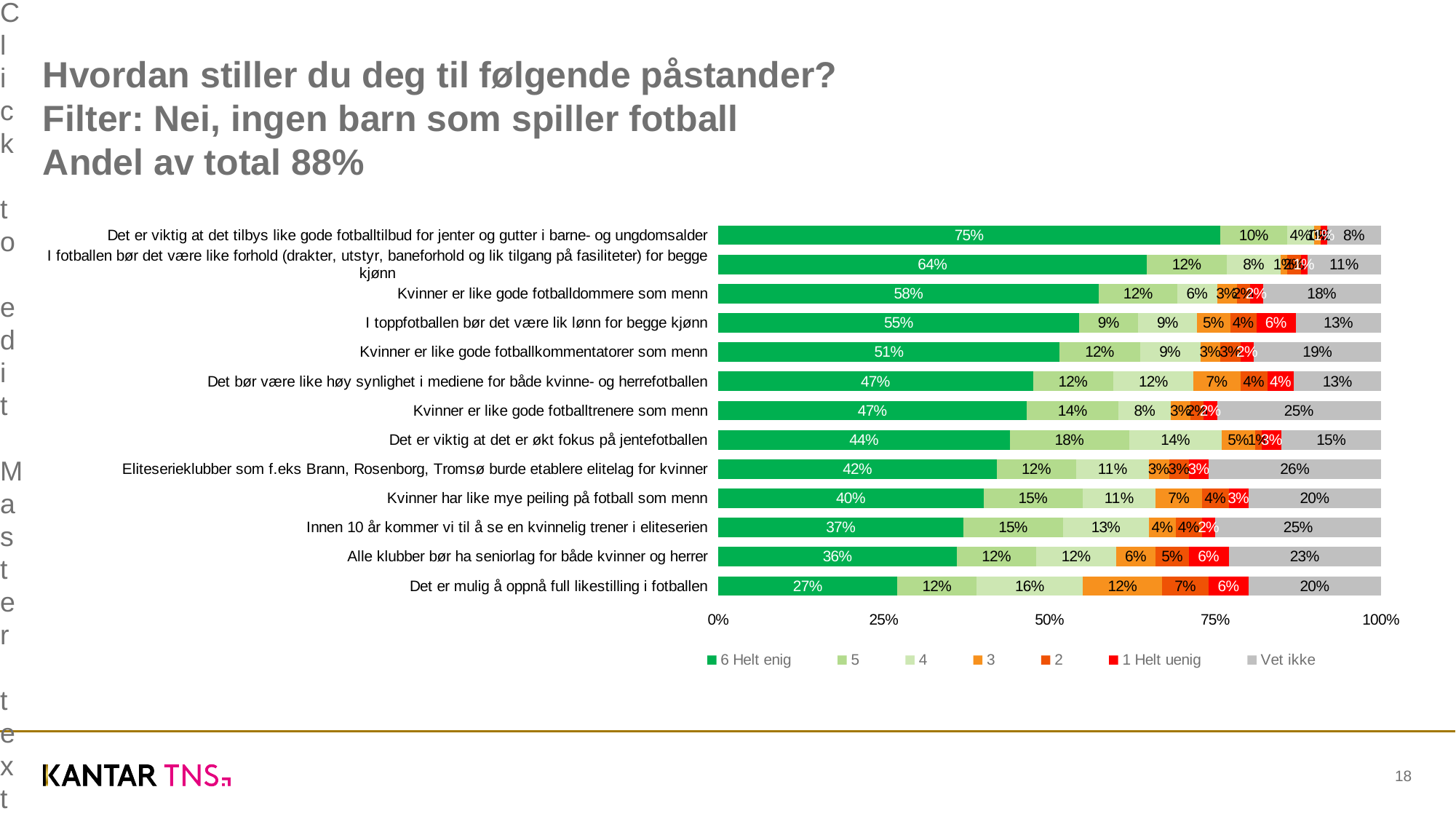
Which has the larger "Vet ikke" share: "Kvinner er like gode fotballtrenere som menn" or "Kvinner har like mye peiling på fotball som menn"? Kvinner er like gode fotballtrenere som menn What is the "Vet ikke" share for the statement "Eliteserieklubber som f.eks Brann, Rosenborg, Tromsø burde etablere elitelag for kvinner"? 26% What is the value of the "3" segment for the statement "I toppfotballen bør det være lik lønn for begge kjønn"? 5% What kind of chart is shown on the slide? Stacked bar chart What is the "1 Helt uenig" share for the statement "Det er mulig å oppnå full likestilling i fotballen"? 6% How many series does the legend list? 7 Which statement has the highest "6 Helt enig" share? Det er viktig at det tilbys like gode fotballtilbud for jenter og gutter i barne- og ungdomsalder What percentage answered "6 Helt enig" to the statement "Det er mulig å oppnå full likestilling i fotballen"? 27% Is the "6 Helt enig" share for "Alle klubber bør ha seniorlag for både kvinner og herrer" greater or less than 50%? less How many statements are shown in the chart? 13 Which statement has the lowest "6 Helt enig" share? Det er mulig å oppnå full likestilling i fotballen How many percentage points higher is the "6 Helt enig" share for "Kvinner er like gode fotballdommere som menn" than for "Kvinner er like gode fotballkommentatorer som menn"? 7 percentage points